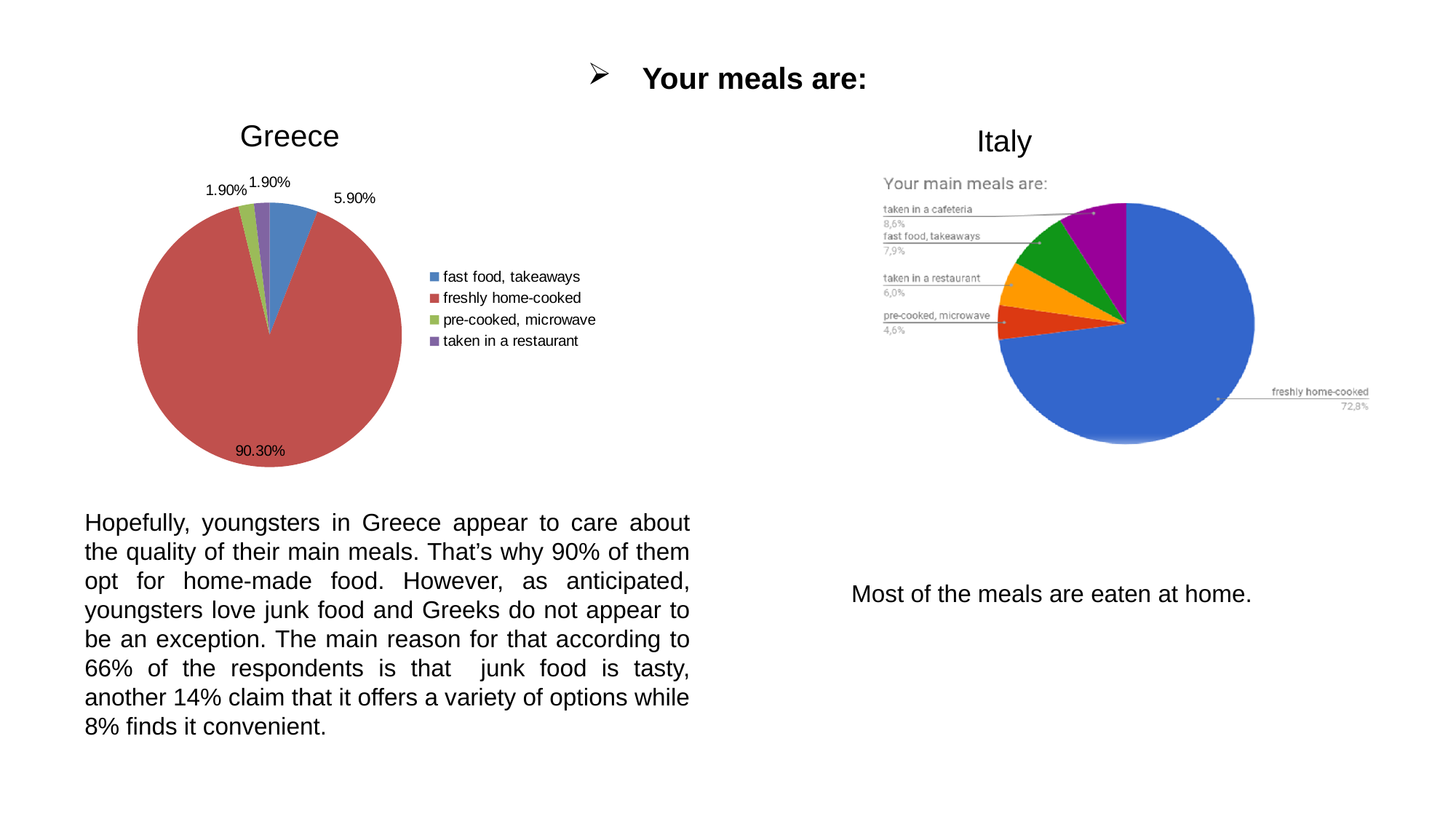
In the Italy chart, what percentage of meals are taken in a cafeteria? 8,6% In the Italy chart, what is the difference between the fast food, takeaways share and the taken in a restaurant share? 1,9% In the Italy chart, what percentage is shown for freshly home-cooked meals? 72,8% In the Greece chart, what percentage is shown for fast food, takeaways? 5.90% How many categories does the Italy chart show? 5 In the Greece chart, what share of meals are freshly home-cooked? 90.30% What type of chart is the Greece chart? pie chart In the Greece chart, which category has the largest slice? freshly home-cooked In the Greece chart, what colour is the freshly home-cooked slice? red How many entries does the legend of the Greece chart list? 4 In the Italy chart, which is larger: taken in a cafeteria or pre-cooked, microwave? taken in a cafeteria In the Italy chart, which category has the smallest slice? pre-cooked, microwave